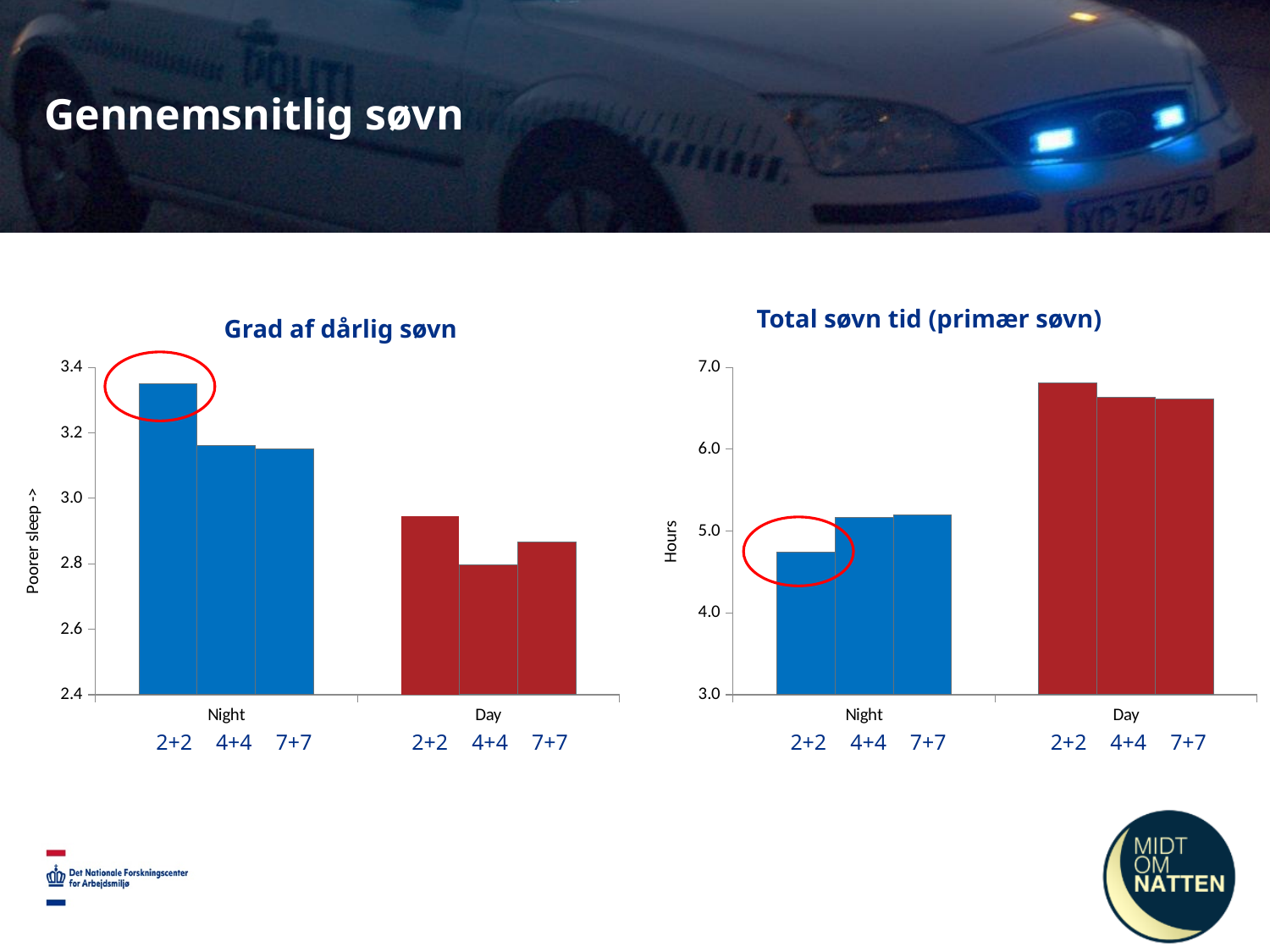
In the 'Total søvn tid (primær søvn)' chart, is the value for Night 2+2 greater or less than 5.0? less In the 'Grad af dårlig søvn' chart, which is larger: Night 2+2 or Day 2+2? Night 2+2 How many bars are plotted in the 'Total søvn tid (primær søvn)' chart? 6 In the 'Total søvn tid (primær søvn)' chart, which bar is the lowest? Night 2+2 In the 'Total søvn tid (primær søvn)' chart, is the value for Day 2+2 greater or less than 6.0? greater In the 'Grad af dårlig søvn' chart, is the value for Night 2+2 greater or less than 3.2? greater In the 'Grad af dårlig søvn' chart, which bar is the highest? Night 2+2 In the 'Total søvn tid (primær søvn)' chart, which bar is the highest? Day 2+2 In the 'Grad af dårlig søvn' chart, which bar is the lowest? Day 4+4 In the 'Total søvn tid (primær søvn)' chart, which is larger: Night 4+4 or Night 2+2? Night 4+4 What kind of chart is the 'Grad af dårlig søvn' chart? bar chart What is the y-axis label of the 'Total søvn tid (primær søvn)' chart? Hours